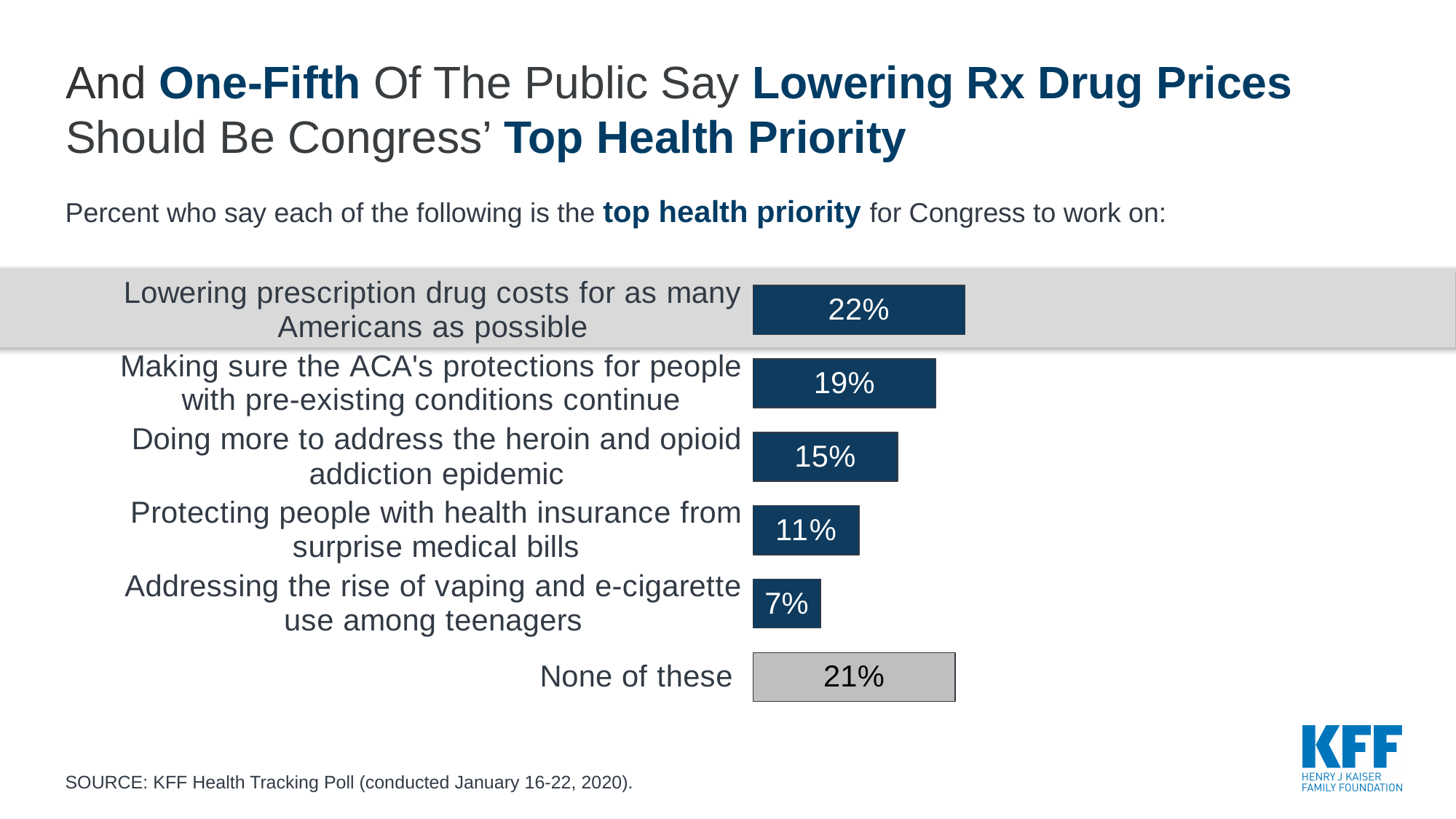
What percent say doing more to address the heroin and opioid addiction epidemic is the top health priority? 15% How many categories are shown in the chart? 6 Which category has the lowest percentage? Addressing the rise of vaping and e-cigarette use among teenagers What is the difference in percentage points between lowering prescription drug costs and addressing the heroin and opioid addiction epidemic? 7 Which category has the highest percentage? Lowering prescription drug costs for as many Americans as possible What type of chart is shown on the slide? Bar chart What percent say addressing the rise of vaping and e-cigarette use among teenagers is the top health priority? 7% Which is larger: the percentage for surprise medical bills or the percentage for vaping and e-cigarette use among teenagers? Surprise medical bills What percent say lowering prescription drug costs for as many Americans as possible is the top health priority for Congress? 22% What percent say making sure the ACA's protections for people with pre-existing conditions continue is the top health priority? 19% What percent say protecting people with health insurance from surprise medical bills is the top health priority? 11% What percent say none of these is the top health priority? 21%